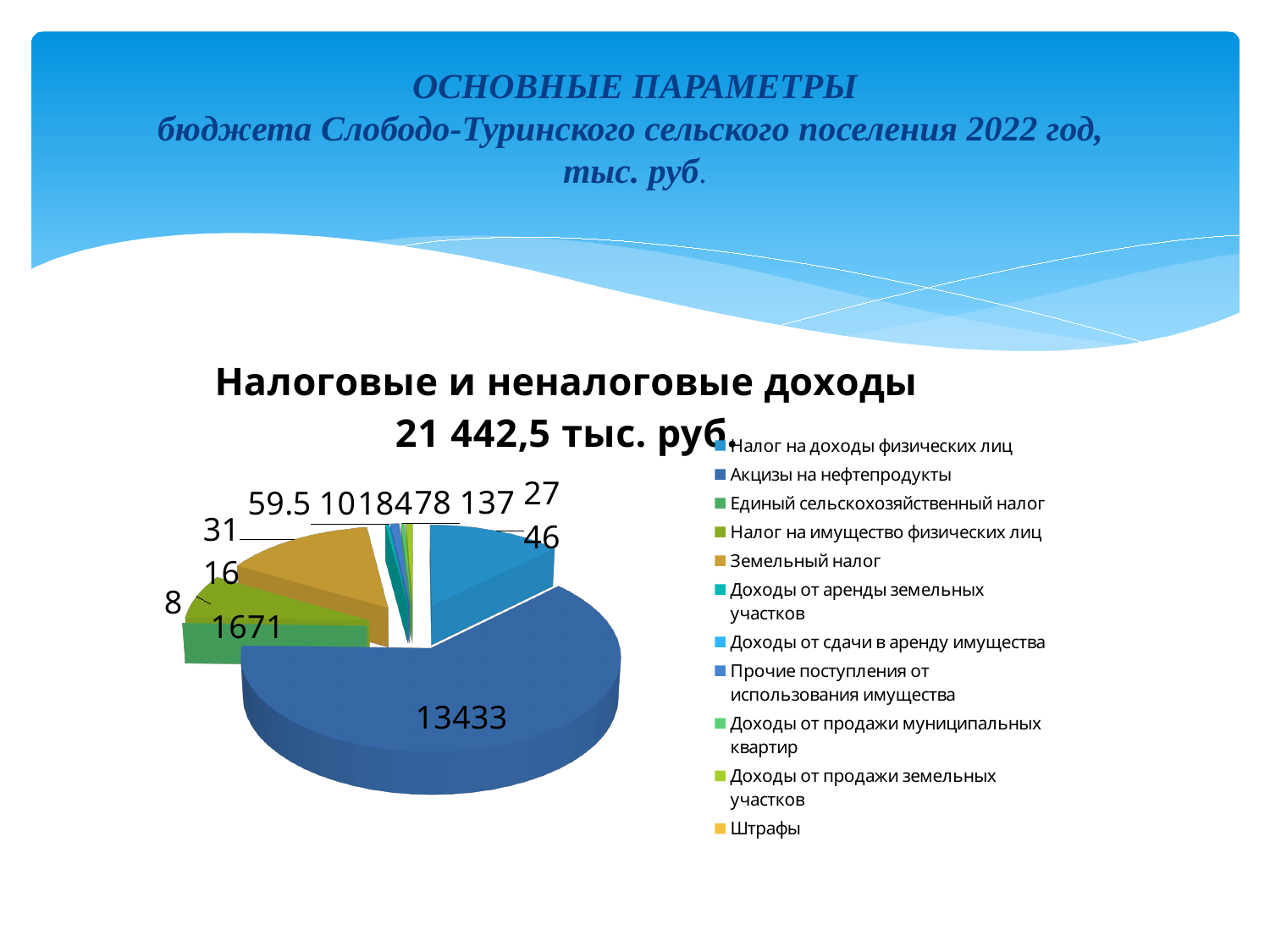
What is the smallest value printed as a data label on the pie chart? 8 What kind of chart is shown on the slide? pie chart Is the value for Акцизы на нефтепродукты greater or less than 10000? greater How many categories does the chart legend list? 11 What is the value shown for Акцизы на нефтепродукты? 13433 What is the title of the chart? Налоговые и неналоговые доходы 21 442,5 тыс. руб. What total amount is stated in the chart title? 21 442,5 тыс. руб. Which is larger, the slice for Акцизы на нефтепродукты or the slice for Налог на доходы физических лиц? Акцизы на нефтепродукты Which category has the largest slice of the pie? Акцизы на нефтепродукты